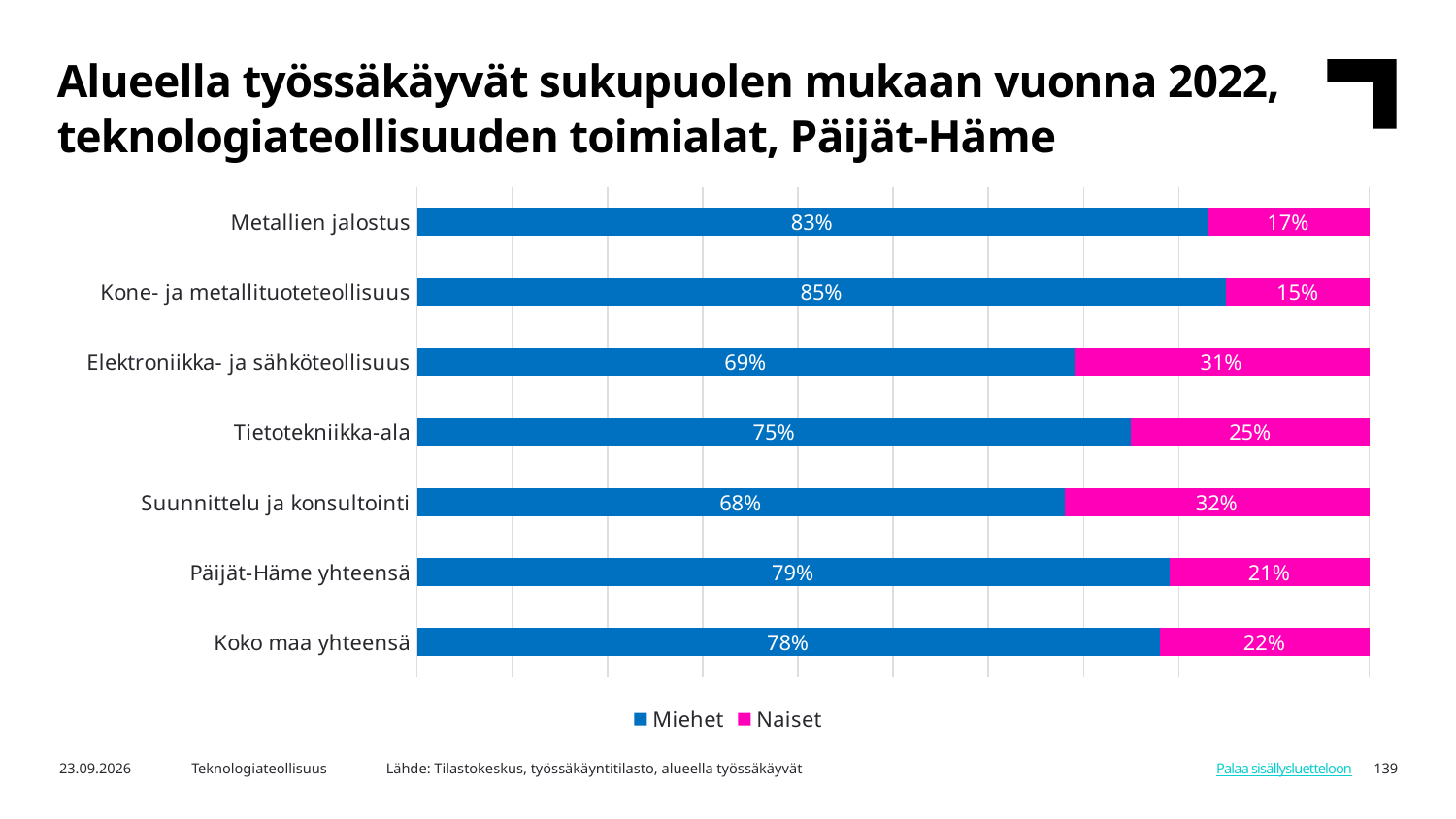
Which category has the highest Naiset share? Suunnittelu ja konsultointi How many series does the legend list? 2 Which category has the lowest Miehet share? Suunnittelu ja konsultointi What is the Miehet share for Metallien jalostus? 83% What is the Naiset share for Koko maa yhteensä? 22% What kind of chart is shown on the slide? Stacked bar chart How many categories are shown on the chart? 7 What is the total of the stacked bar for Kone- ja metallituoteteollisuus? 100% Which category has the highest Miehet share? Kone- ja metallituoteteollisuus Which is larger: the Naiset share for Päijät-Häme yhteensä or for Koko maa yhteensä? Koko maa yhteensä What is the Naiset share for Elektroniikka- ja sähköteollisuus? 31% What is the difference between the Miehet share and the Naiset share for Tietotekniikka-ala? 50 percentage points